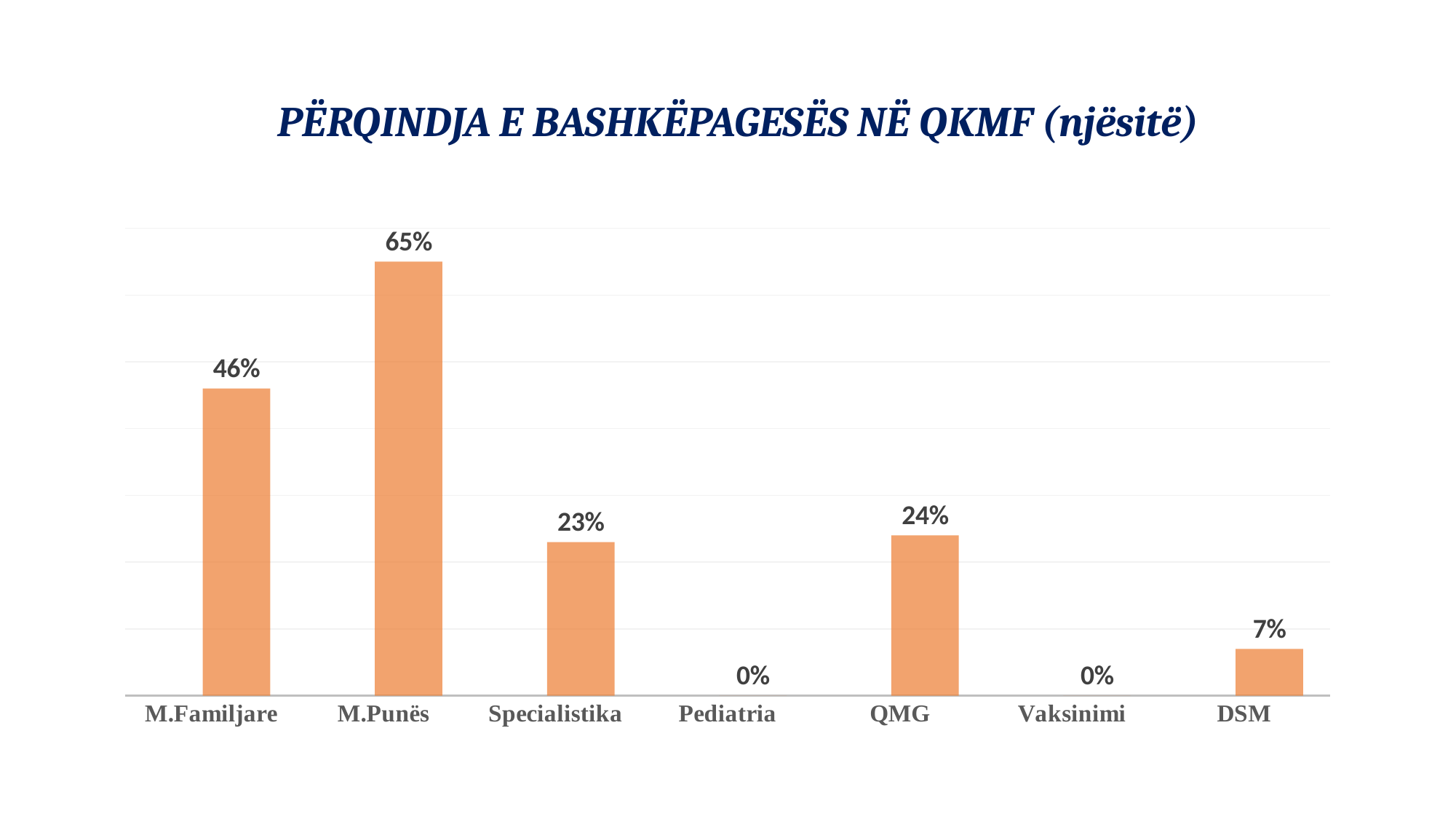
What is the value for DSM? 7% What is the value for QMG? 24% What is the title of the chart? PËRQINDJA E BASHKËPAGESËS NË QKMF (njësitë) How many categories are shown on the x axis? 7 What is the value for M.Punës? 65% What is the difference between the values for QMG and Specialistika? 1% Which categories have a value of 0%? Pediatria and Vaksinimi Which category has the highest value? M.Punës What is the value for M.Familjare? 46% Which is larger, the value for M.Familjare or the value for Specialistika? M.Familjare What kind of chart is shown on the slide? Bar chart What is the difference between the values for M.Punës and M.Familjare? 19%